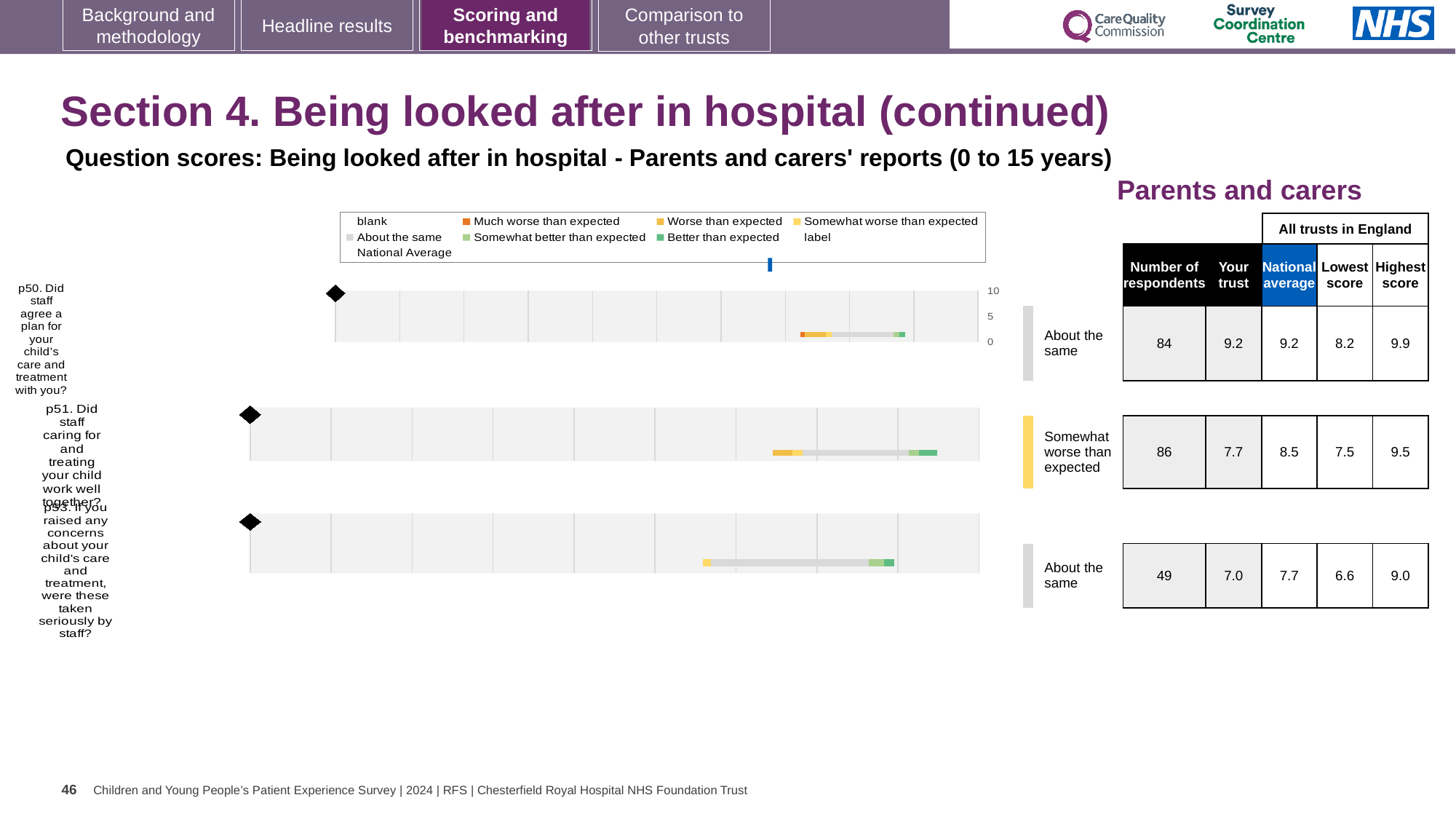
What is the 'Your trust' score for p53 (If you raised any concerns about your child's care and treatment, were these taken seriously by staff?)? 7.0 How many respondents answered p51? 86 Which of the three questions has the lowest number of respondents? p53 Which benchmark category is p51 rated as? Somewhat worse than expected What is the 'Your trust' score for p50 (Did staff agree a plan for your child's care and treatment with you?)? 9.2 Which of the three questions has the highest 'Your trust' score? p50 What is the difference between the national average and the 'Your trust' score for p51? 0.8 Which is larger for p53: the 'Your trust' score or the national average? National average What is the national average for p51 (Did staff caring for and treating your child work well together?)? 8.5 What is the highest score among all trusts in England for p50? 9.9 What is the lowest score among all trusts in England for p53? 6.6 How many questions (rows) are plotted in the chart? 3